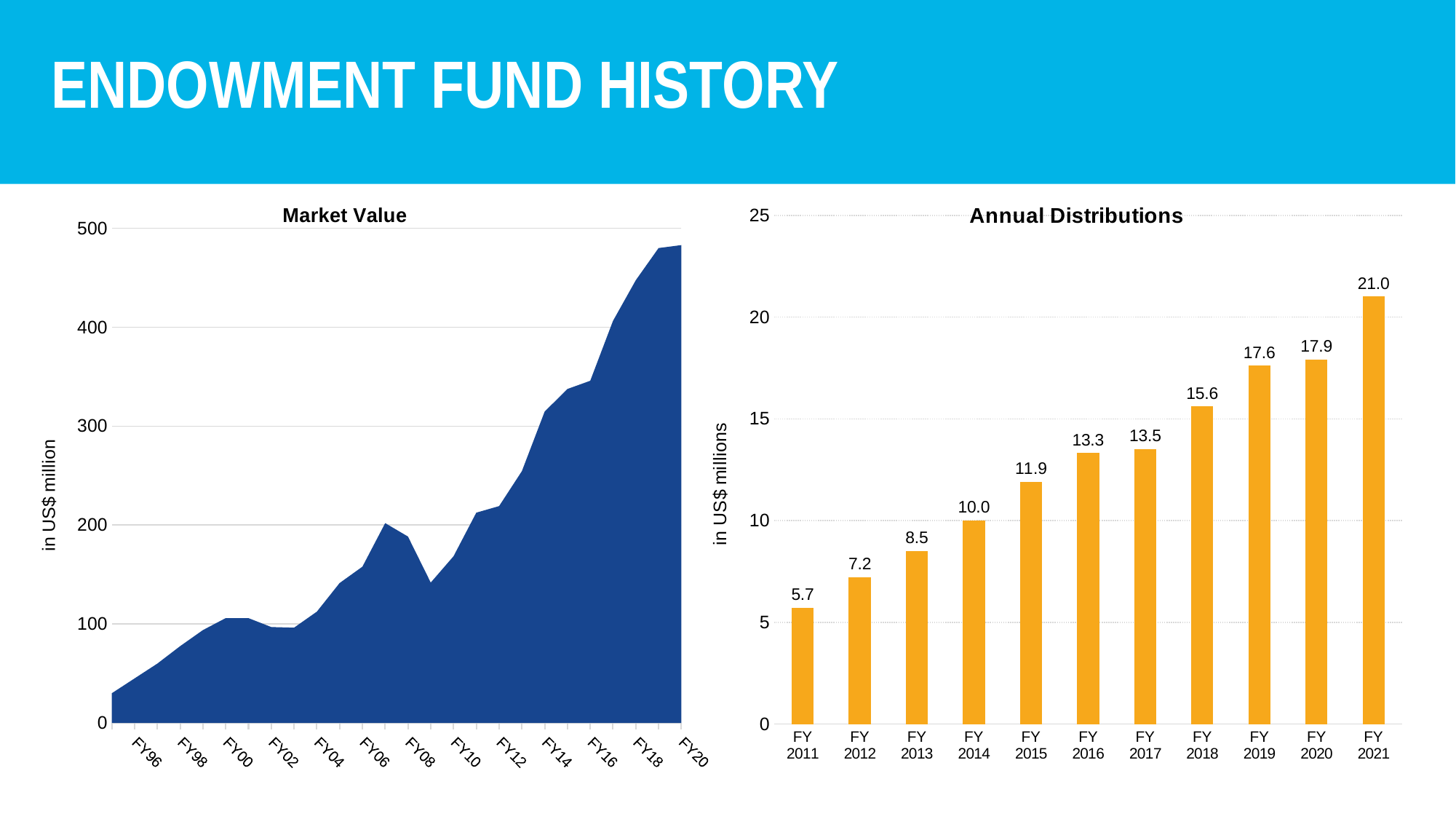
How many bars are shown in the Annual Distributions chart? 11 In the Annual Distributions chart, what is the value for FY 2014? 10.0 What kind of chart is the Market Value chart on the left? area chart In the Annual Distributions chart, which fiscal year has the lowest distribution? FY 2011 In the Annual Distributions chart, what is the difference between the FY 2021 and FY 2011 values? 15.3 In the Annual Distributions chart, which is larger, the value for FY 2016 or FY 2017? FY 2017 Do the values in the Annual Distributions chart rise or fall from FY 2011 to FY 2021? rise In the Market Value chart, is the value for FY20 greater or less than 400? greater In the Annual Distributions chart, what is the value for FY 2018? 15.6 What unit is shown on the y-axis of the Annual Distributions chart? in US$ millions In the Annual Distributions chart, which fiscal year has the highest distribution? FY 2021